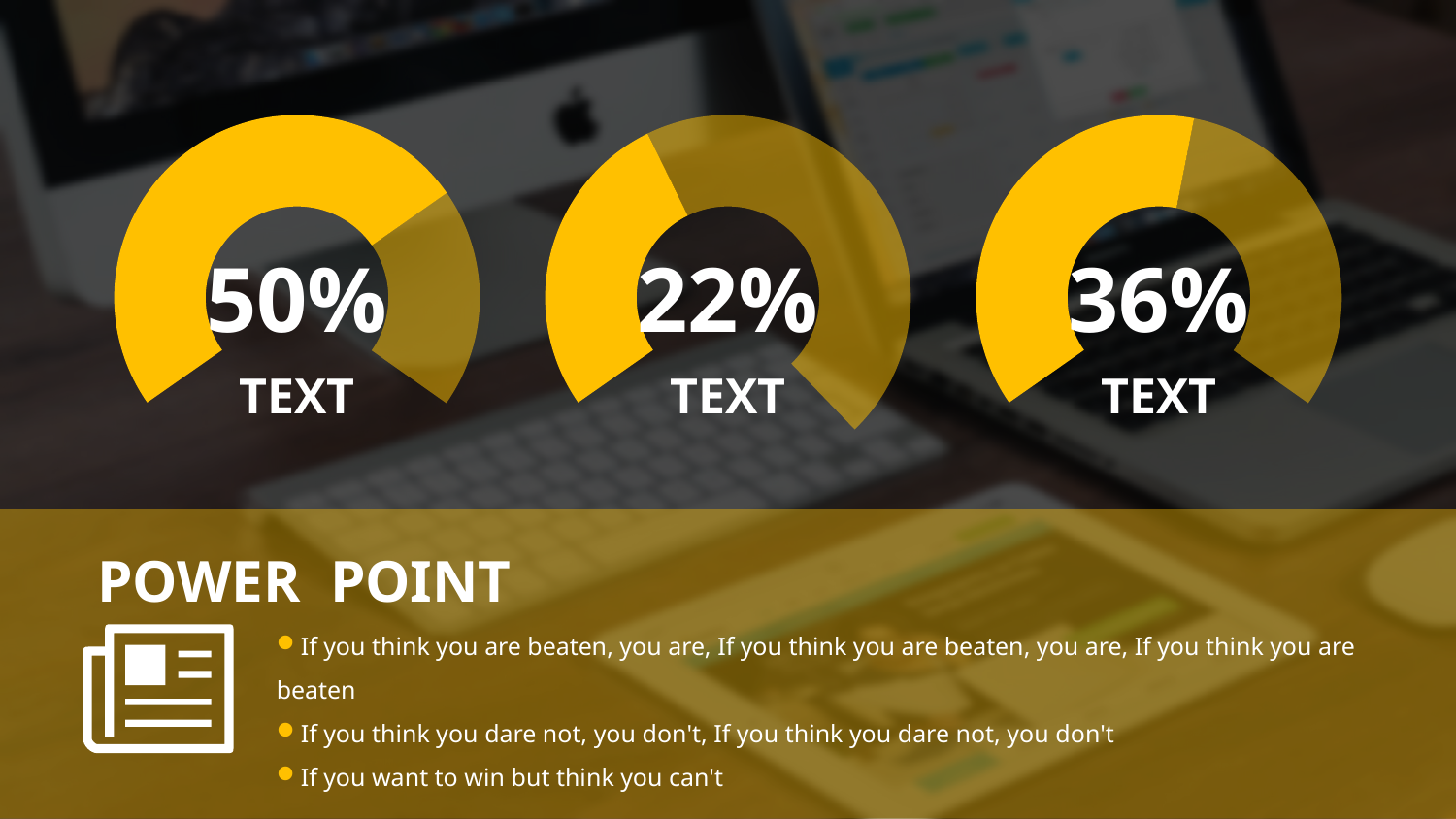
What percentage is shown in the middle gauge chart? 22% What colour is the filled portion of the gauge charts? yellow Is the percentage in the right gauge chart greater or less than 50%? less What percentage is shown in the left gauge chart? 50% What is the difference between the percentage in the left gauge chart and the percentage in the middle gauge chart? 28% How many gauge charts are on the slide? 3 What label appears below the percentage in each gauge chart? TEXT What is the difference between the percentage in the right gauge chart and the percentage in the middle gauge chart? 14% Which of the three gauge charts shows the lowest percentage: left, middle or right? middle Which shows a larger percentage, the middle gauge chart or the right gauge chart? right What percentage is shown in the right gauge chart? 36% Which of the three gauge charts shows the highest percentage: left, middle or right? left